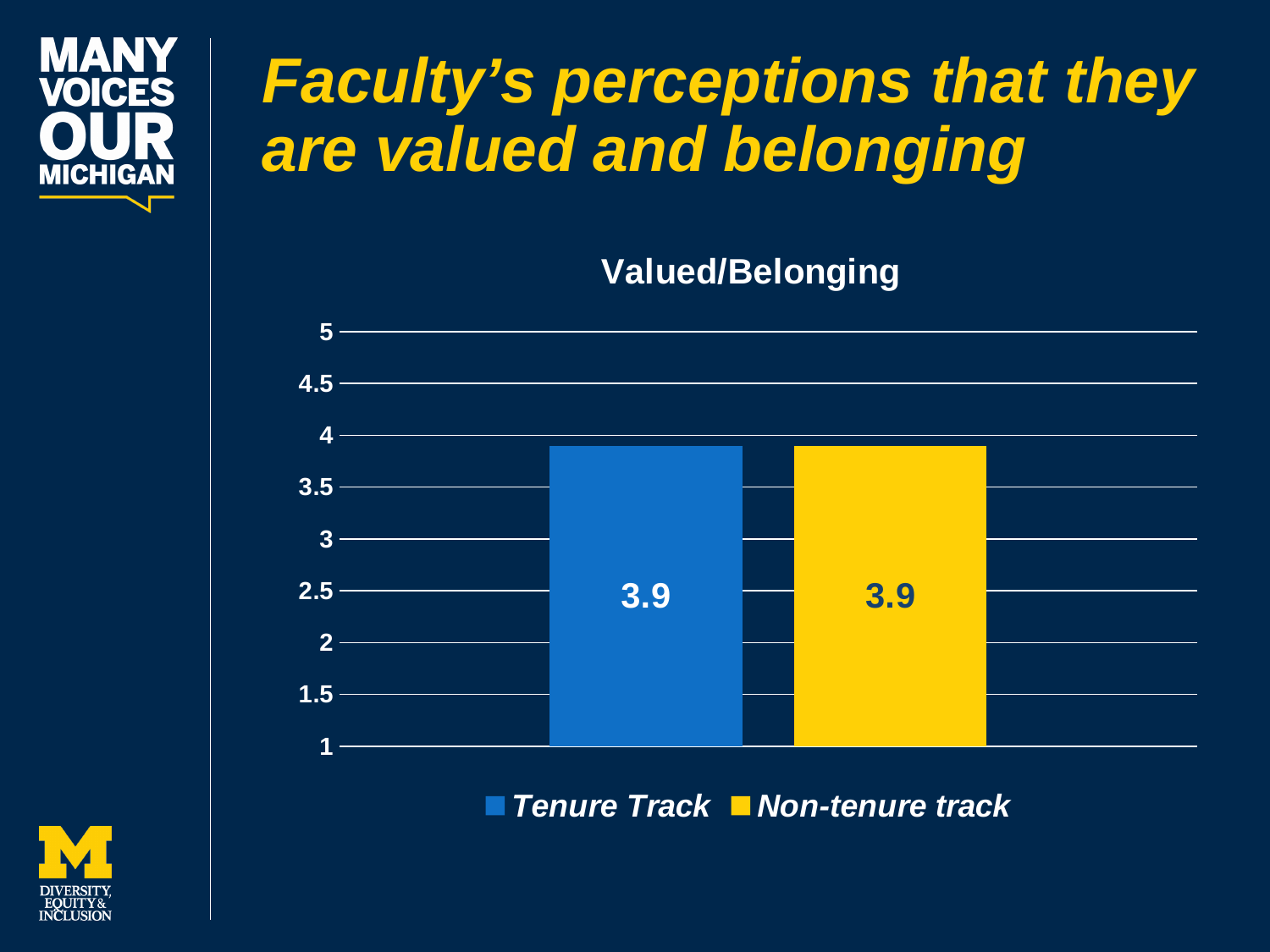
What kind of chart is shown on the slide? Bar chart What is the highest value shown on the vertical axis? 5 What is the value for Tenure Track in the Valued/Belonging chart? 3.9 What is the value for Non-tenure track in the Valued/Belonging chart? 3.9 What is the difference between the Tenure Track and Non-tenure track values? 0 Is the value for Non-tenure track greater or less than 4? less Which colour represents Non-tenure track in the chart? Yellow What is the title of the chart? Valued/Belonging How many series does the legend list? 2 Is the value for Tenure Track greater or less than 3.5? greater How many bars are plotted in the chart? 2